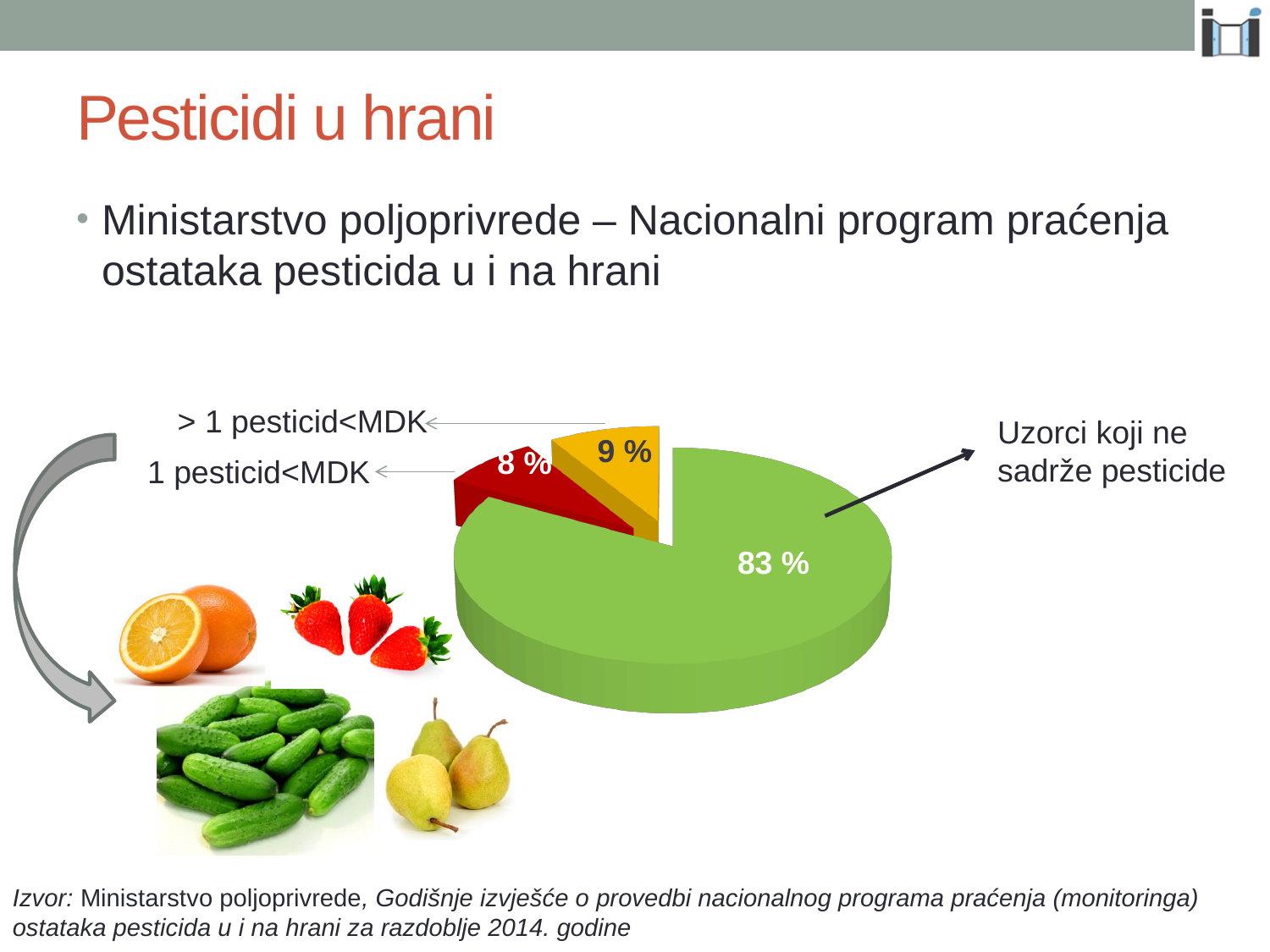
What is the difference in percentage points between the "Uzorci koji ne sadrže pesticide" slice and the "> 1 pesticid<MDK" slice? 74 % What is the difference between the "> 1 pesticid<MDK" slice and the "1 pesticid<MDK" slice? 1 % What percentage is shown for the "1 pesticid<MDK" slice? 8 % Which slice of the pie chart is the smallest? 1 pesticid<MDK What kind of chart is shown on the slide? pie chart Which is larger: the "> 1 pesticid<MDK" slice or the "1 pesticid<MDK" slice? > 1 pesticid<MDK What colour is the largest slice of the pie chart? green Which slice of the pie chart is the largest? Uzorci koji ne sadrže pesticide How many slices does the pie chart have? 3 What colour is the "1 pesticid<MDK" slice? red What percentage is shown for the "> 1 pesticid<MDK" slice? 9 % What share of samples is labelled "Uzorci koji ne sadrže pesticide" in the pie chart? 83 %